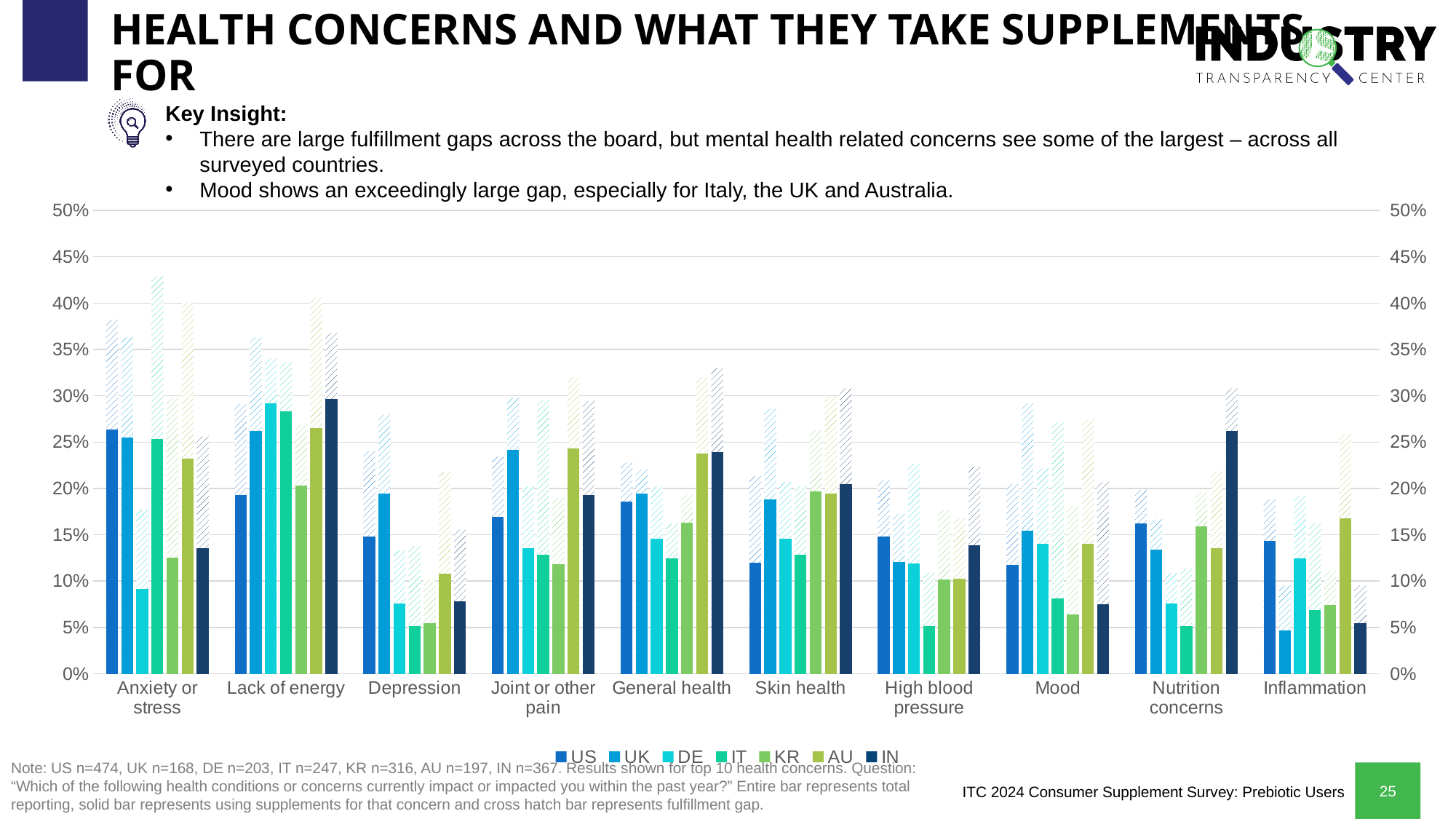
Is the solid bar for AU under Inflammation greater or less than 15%? greater Which country has the highest solid bar for Depression? UK Which country has the lowest solid bar for Nutrition concerns? IT For Skin health, which solid bar is larger, KR or US? KR For Joint or other pain, which solid bar is larger, UK or IT? UK Is the solid bar for DE under Anxiety or stress greater or less than 10%? less What kind of chart is shown on the slide? bar chart Is the solid bar for US under General health greater or less than 20%? less Which country has the highest solid bar for Mood? UK How many health concern categories are shown on the x axis? 10 How many series does the legend list? 7